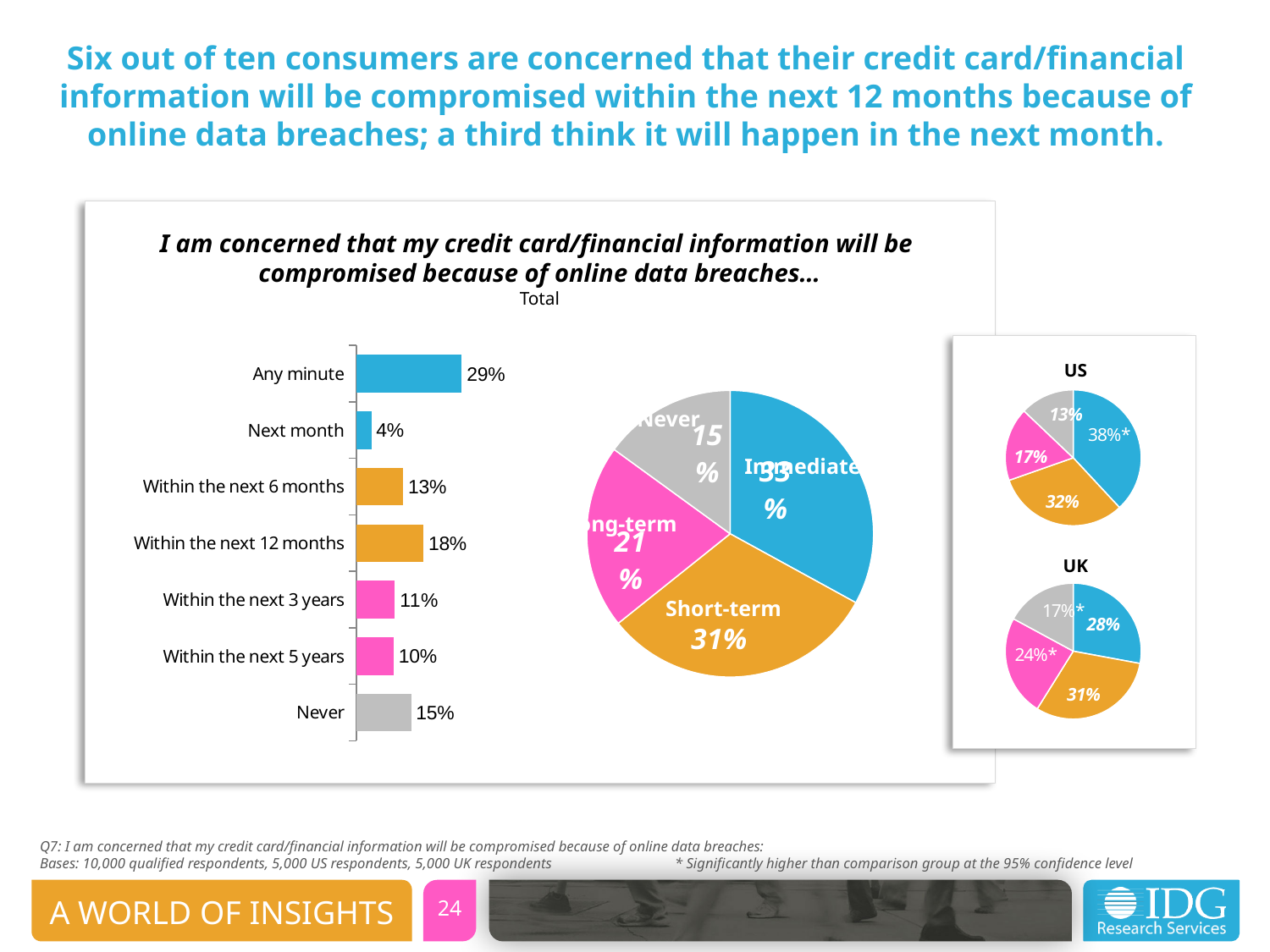
In the bar chart, which category has the lowest value? Next month In the large Total pie chart, what share is 'Never'? 15% How many categories does the bar chart show? 7 In the bar chart, which is larger: 'Within the next 5 years' or 'Never'? Never In the bar chart, which category has the highest value? Any minute In the large Total pie chart, what share is 'Short-term'? 31% In the bar chart, what is the value for 'Within the next 12 months'? 18% What kind of chart is the chart on the left of the slide? Bar chart In the UK pie chart, what is the value of the blue slice? 28% In the US pie chart, what is the value of the orange slice? 32% In the bar chart, what is the difference between 'Within the next 6 months' and 'Within the next 3 years'? 2 percentage points In the bar chart, what is the value for 'Any minute'? 29%